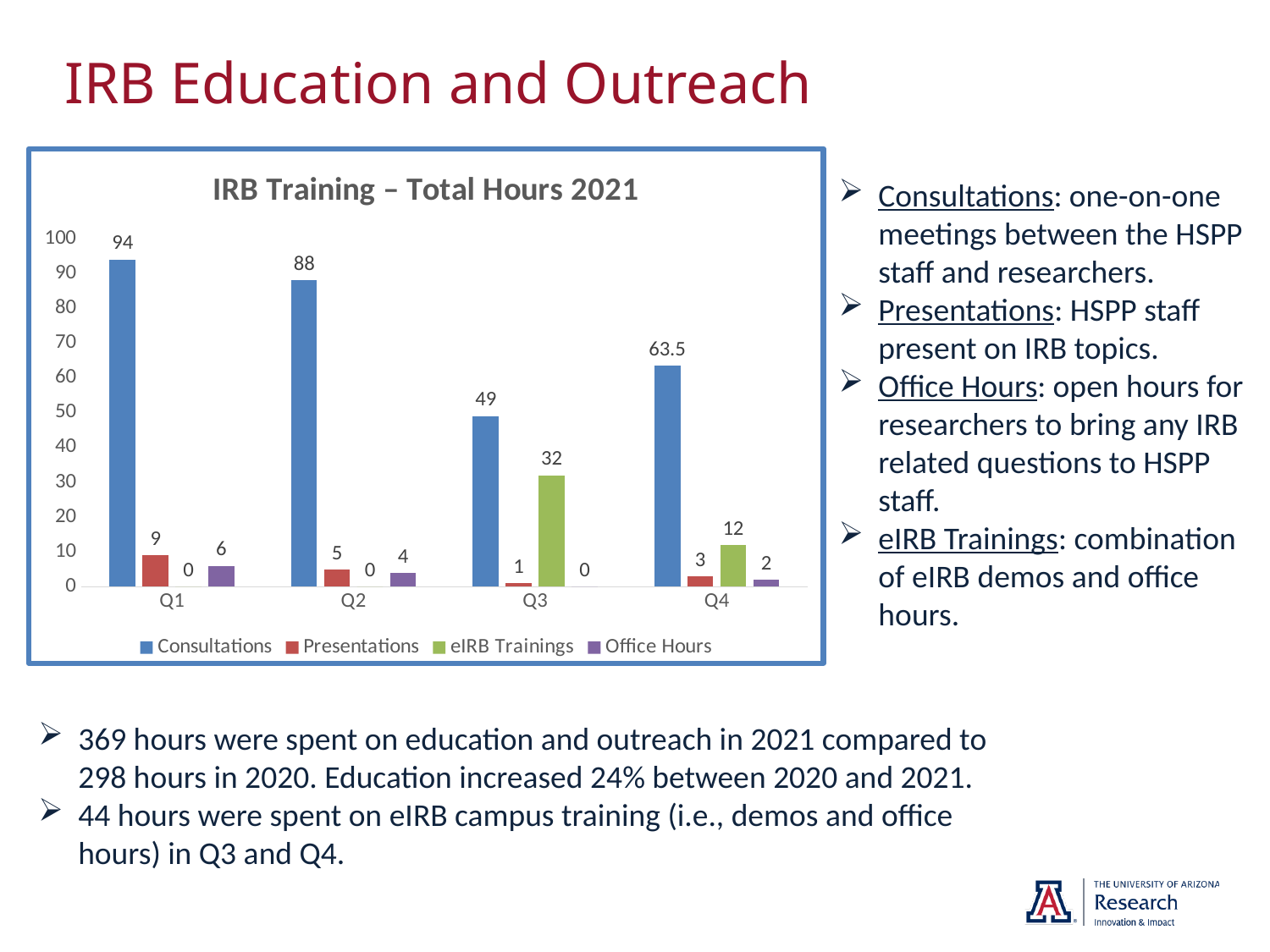
Which is larger: eIRB Trainings in Q3 or eIRB Trainings in Q4? eIRB Trainings in Q3 What is the value for eIRB Trainings in Q3? 32 What is the value for Office Hours in Q2? 4 What is the value for Consultations in Q4? 63.5 In which quarter is the Consultations value lowest? Q3 What is the difference between Consultations in Q1 and Consultations in Q2? 6 In which quarter is the Consultations value highest? Q1 What is the value for Consultations in Q1? 94 How many quarters are shown on the x axis? 4 What is the title of the chart? IRB Training – Total Hours 2021 How many series does the legend list? 4 What kind of chart is shown? Bar chart